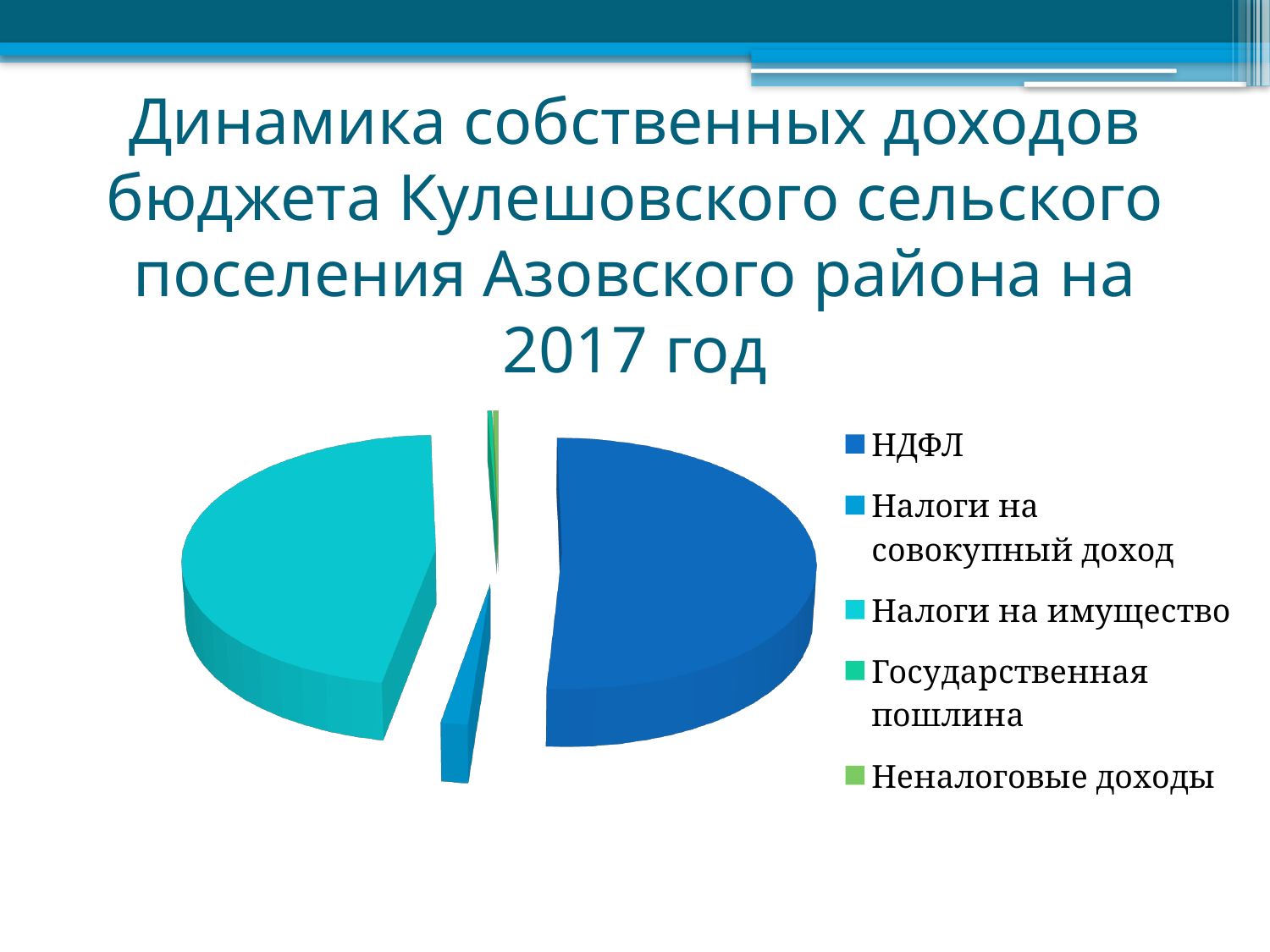
How many categories does the legend of the pie chart list? 5 Which category has the largest slice of the pie chart? НДФЛ Which slice is larger: Налоги на имущество or Государственная пошлина? Налоги на имущество Which slice is larger: Налоги на имущество or Налоги на совокупный доход? Налоги на имущество Which slice is larger: НДФЛ or Неналоговые доходы? НДФЛ What kind of chart is shown on the slide? pie chart What year does the slide title say the chart refers to? 2017 Which category is shown in the dark blue colour in the pie chart legend? НДФЛ